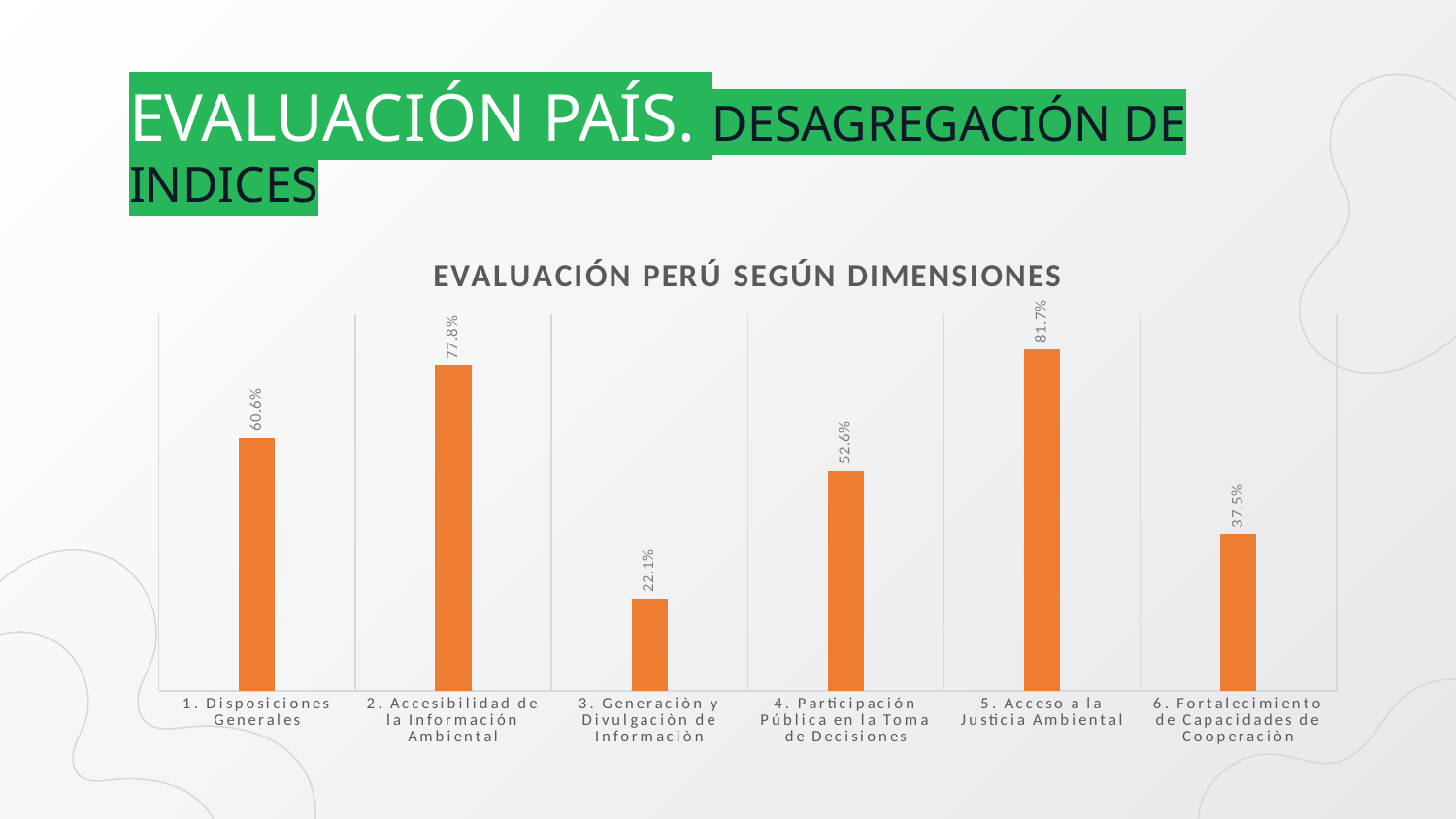
What is the value for '6. Fortalecimiento de Capacidades de Cooperaciòn'? 37.5% Which dimension has the lowest value? 3. Generaciòn y Divulgaciòn de Informaciòn What is the title of the chart? EVALUACIÓN PERÚ SEGÚN DIMENSIONES What is the value for '5. Acceso a la Justicia Ambiental'? 81.7% What is the value for '3. Generaciòn y Divulgaciòn de Informaciòn'? 22.1% How many dimensions are shown in the chart? 6 Which is larger, the value for '1. Disposiciones Generales' or the value for '6. Fortalecimiento de Capacidades de Cooperaciòn'? 1. Disposiciones Generales What is the difference between the values for '2. Accesibilidad de la Información Ambiental' and '4. Participación Pública en la Toma de Decisiones'? 25.2% Which dimension has the highest value? 5. Acceso a la Justicia Ambiental What kind of chart is shown on the slide? Bar chart What colour are the bars in the chart? Orange What is the value for '1. Disposiciones Generales'? 60.6%